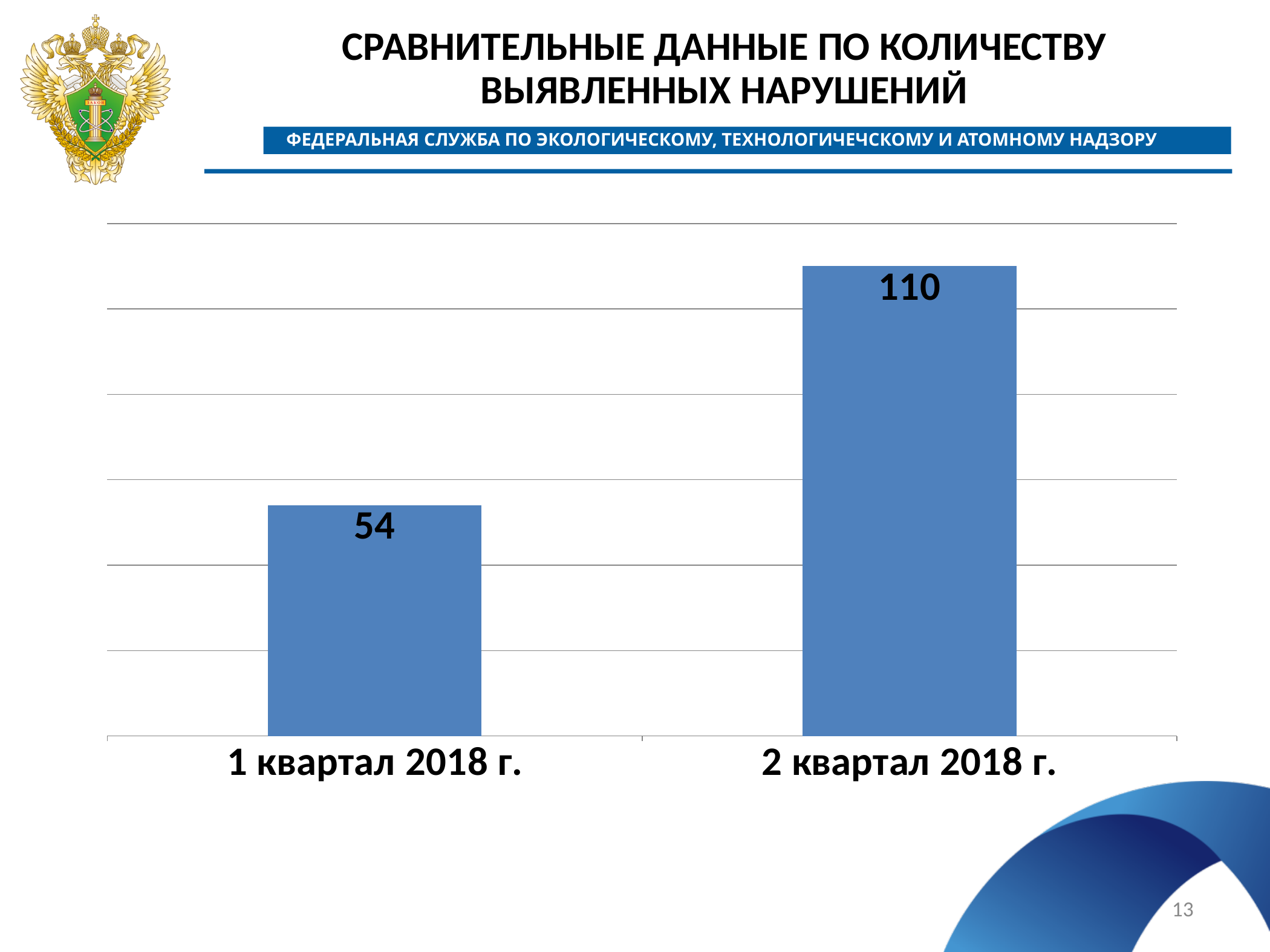
Do the values rise or fall from 1 квартал 2018 г. to 2 квартал 2018 г.? rise What kind of chart is shown on the slide? bar chart Which is larger, the value for 1 квартал 2018 г. or the value for 2 квартал 2018 г.? 2 квартал 2018 г. What is the difference between the values for 2 квартал 2018 г. and 1 квартал 2018 г.? 56 Which category has the highest value? 2 квартал 2018 г. Which category has the lowest value? 1 квартал 2018 г. What is the title of the slide containing the chart? СРАВНИТЕЛЬНЫЕ ДАННЫЕ ПО КОЛИЧЕСТВУ ВЫЯВЛЕННЫХ НАРУШЕНИЙ What is the value for 2 квартал 2018 г.? 110 What is the value for 1 квартал 2018 г.? 54 What colour are the bars in the chart? blue How many categories are shown on the x axis? 2